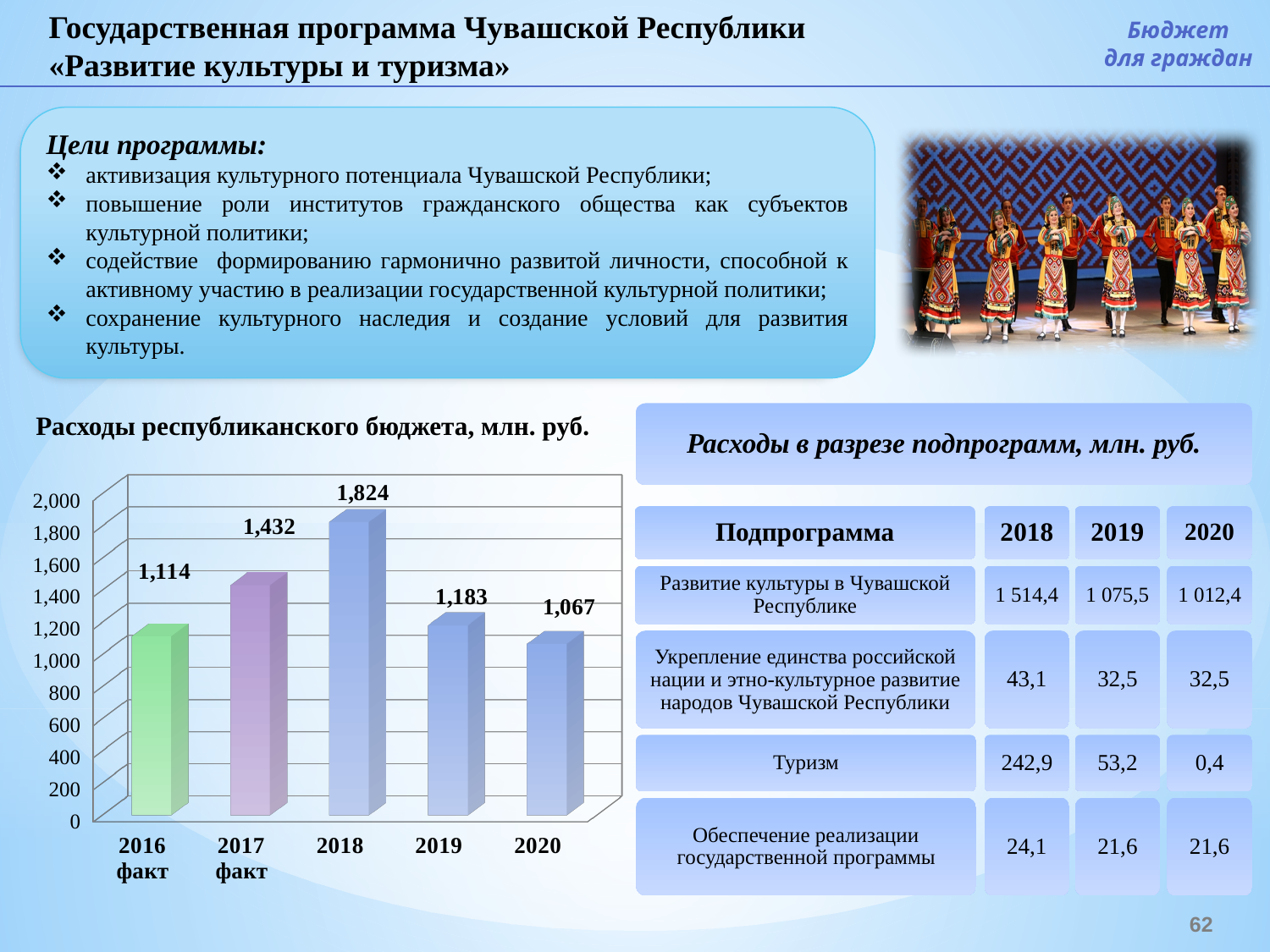
Which year has the lowest value in the chart "Расходы республиканского бюджета, млн. руб."? 2020 Is the value for 2017 факт greater or less than 1,400 in the chart "Расходы республиканского бюджета, млн. руб."? greater In the chart "Расходы республиканского бюджета, млн. руб.", do the values rise or fall from 2018 to 2020? fall What kind of chart is "Расходы республиканского бюджета, млн. руб."? bar chart What is the value for 2018 in the chart "Расходы республиканского бюджета, млн. руб."? 1,824 What is the difference between the values for 2018 and 2019 in the chart "Расходы республиканского бюджета, млн. руб."? 641 What is the difference between the values for 2017 факт and 2016 факт in the chart "Расходы республиканского бюджета, млн. руб."? 318 How many years are shown on the x axis of the chart "Расходы республиканского бюджета, млн. руб."? 5 What is the value for 2020 in the chart "Расходы республиканского бюджета, млн. руб."? 1,067 In the chart "Расходы республиканского бюджета, млн. руб.", which is larger: the value for 2019 or the value for 2020? 2019 Which year has the highest value in the chart "Расходы республиканского бюджета, млн. руб."? 2018 What is the value for 2016 факт in the chart "Расходы республиканского бюджета, млн. руб."? 1,114